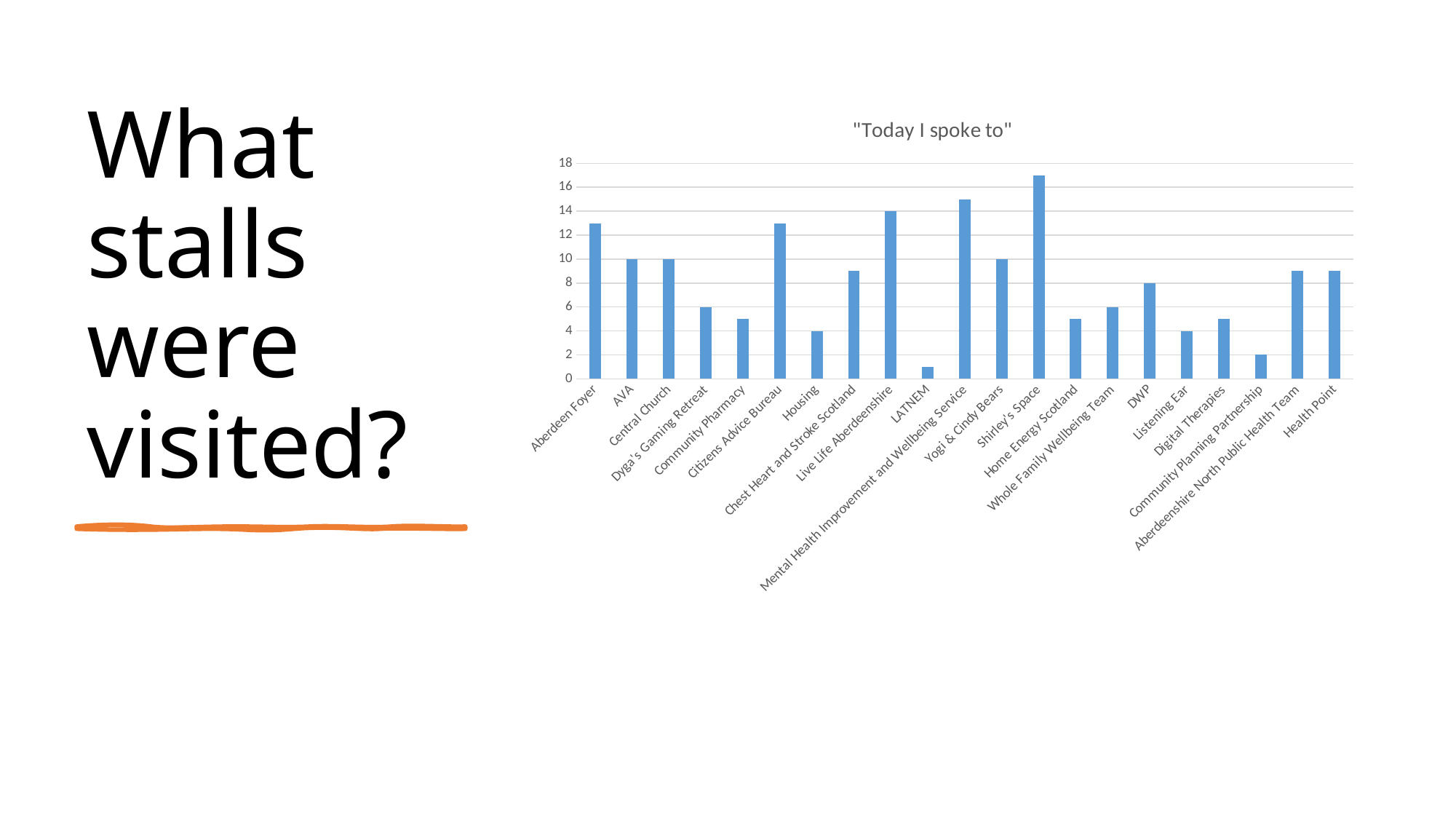
What is the title of the chart? "Today I spoke to" What is the value for Live Life Aberdeenshire? 14 What kind of chart is shown on the slide? bar chart Which stall has the highest value in the chart? Shirley's Space Is the value for Aberdeen Foyer greater or less than 12? greater Is the value for Shirley's Space greater or less than 16? greater Which is larger, the value for Mental Health Improvement and Wellbeing Service or the value for Housing? Mental Health Improvement and Wellbeing Service What is the difference between the values for Live Life Aberdeenshire and DWP? 6 What is the value for Community Planning Partnership? 2 Which stall has the lowest value in the chart? LATNEM How many stalls (categories) are shown on the x axis? 21 What is the value for DWP? 8